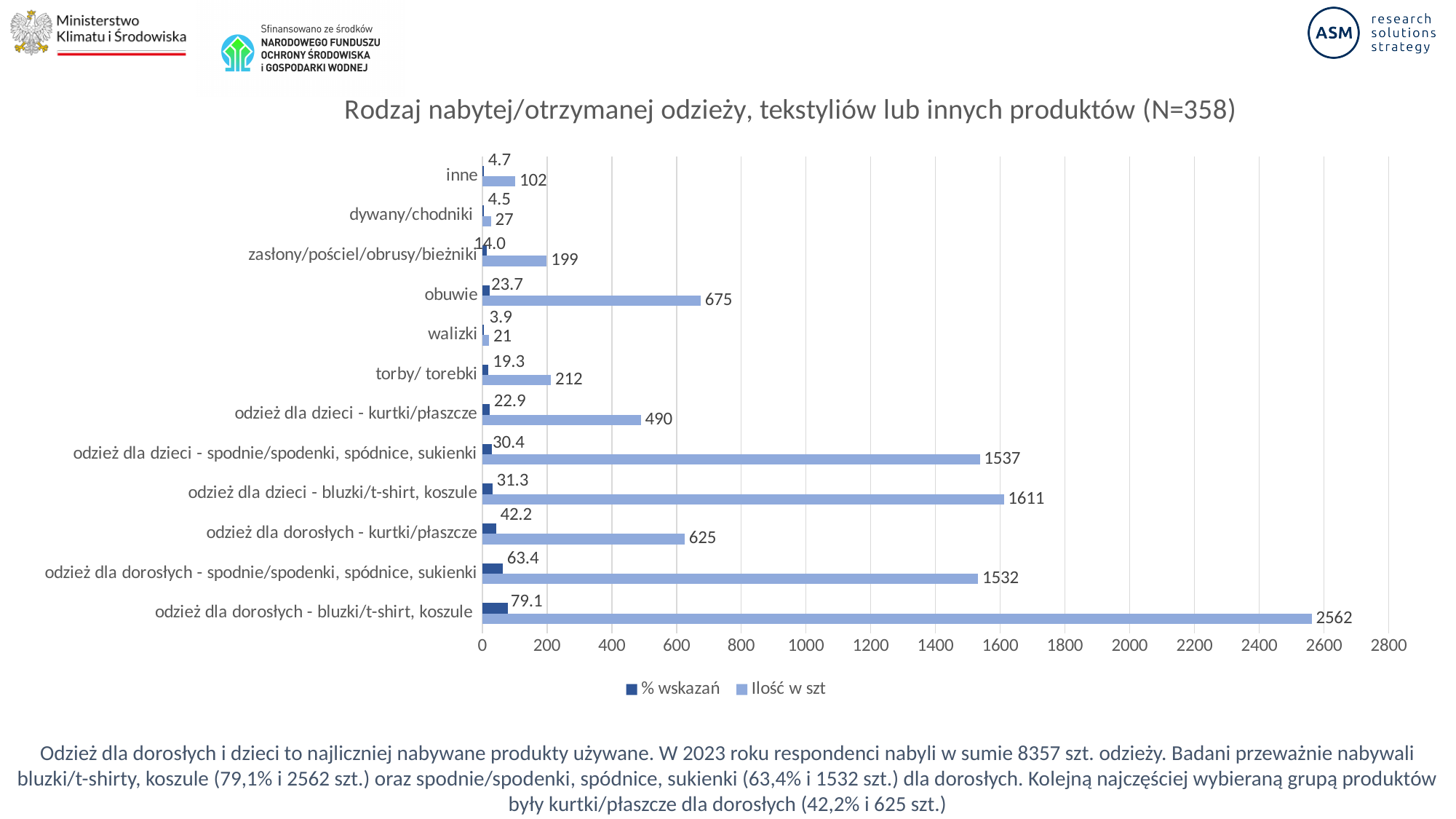
What is the 'Ilość w szt' value for 'odzież dla dzieci - bluzki/t-shirt, koszule'? 1611 Which has a larger 'Ilość w szt' value: 'torby/ torebki' or 'zasłony/pościel/obrusy/bieżniki'? torby/ torebki How many categories are shown on the chart? 12 Which category has the highest 'Ilość w szt' value? odzież dla dorosłych - bluzki/t-shirt, koszule What is the difference in 'Ilość w szt' between 'odzież dla dzieci - spodnie/spodenki, spódnice, sukienki' and 'odzież dla dorosłych - spodnie/spodenki, spódnice, sukienki'? 5 Which category has the lowest '% wskazań' value? walizki What type of chart is shown on the slide? bar chart What is the 'Ilość w szt' value for 'obuwie'? 675 How many series does the legend list? 2 What is the title of the chart? Rodzaj nabytej/otrzymanej odzieży, tekstyliów lub innych produktów (N=358) Is the 'Ilość w szt' value for 'odzież dla dzieci - kurtki/płaszcze' greater or less than 600? less What is the '% wskazań' value for 'odzież dla dorosłych - kurtki/płaszcze'? 42.2